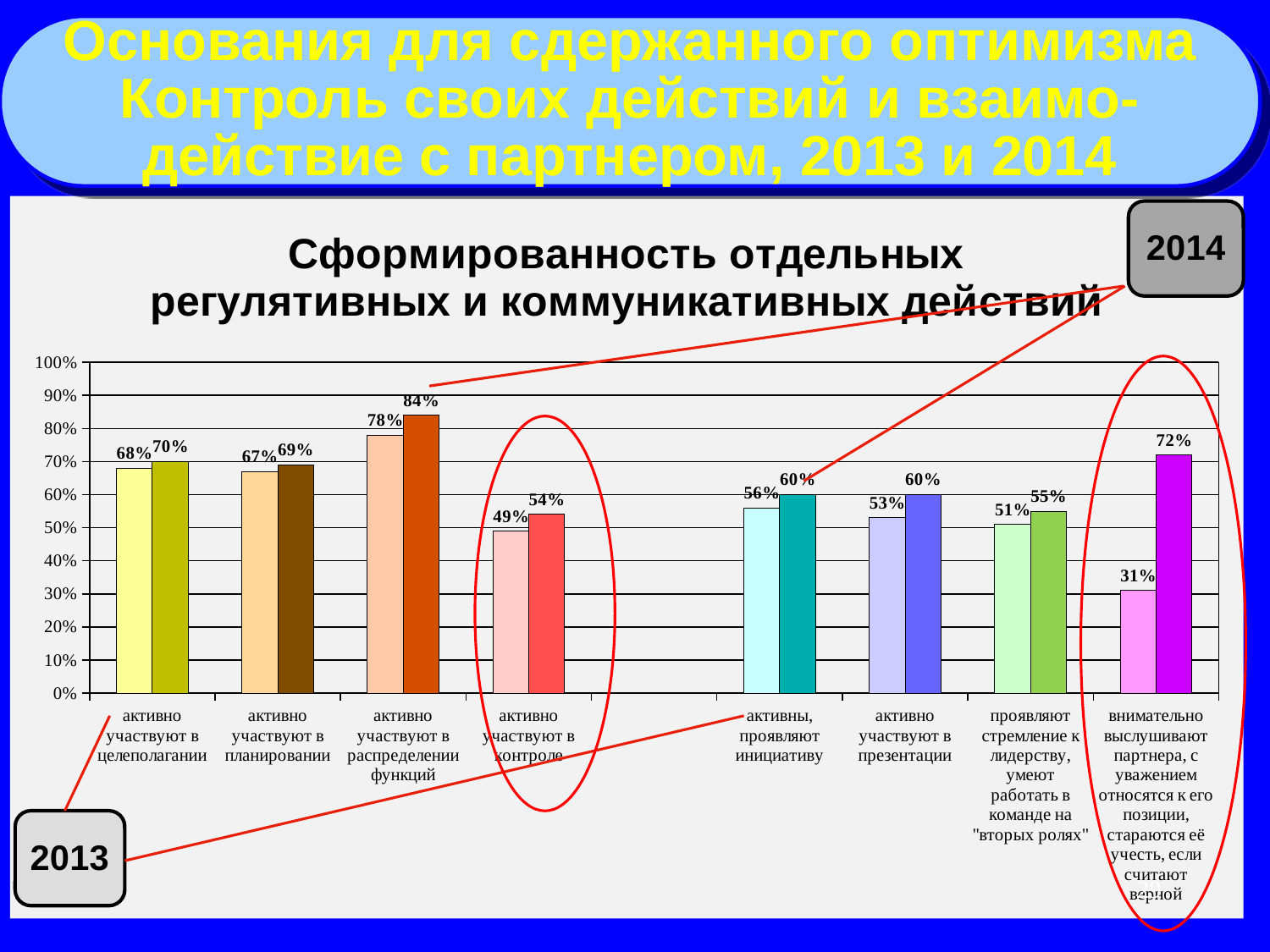
Which category has the lowest 2013 value? внимательно выслушивают партнера, с уважением относятся к его позиции How many categories are shown on the x axis of the chart? 8 What is the 2013 value for "внимательно выслушивают партнера, с уважением относятся к его позиции"? 31% What is the 2014 value for "активно участвуют в презентации"? 60% Which is larger: the 2013 value for "активно участвуют в целеполагании" or the 2013 value for "активны, проявляют инициативу"? активно участвуют в целеполагании What is the difference between the 2014 and 2013 values for "активно участвуют в распределении функций"? 6% What is the 2013 value for "активно участвуют в контроле"? 49% What is the 2014 value for "активно участвуют в распределении функций"? 84% What is the title of the chart? Сформированность отдельных регулятивных и коммуникативных действий What is the difference between the 2014 and 2013 values for "внимательно выслушивают партнера"? 41% Which category has the highest 2014 value? активно участвуют в распределении функций What type of chart is shown on the slide? bar chart